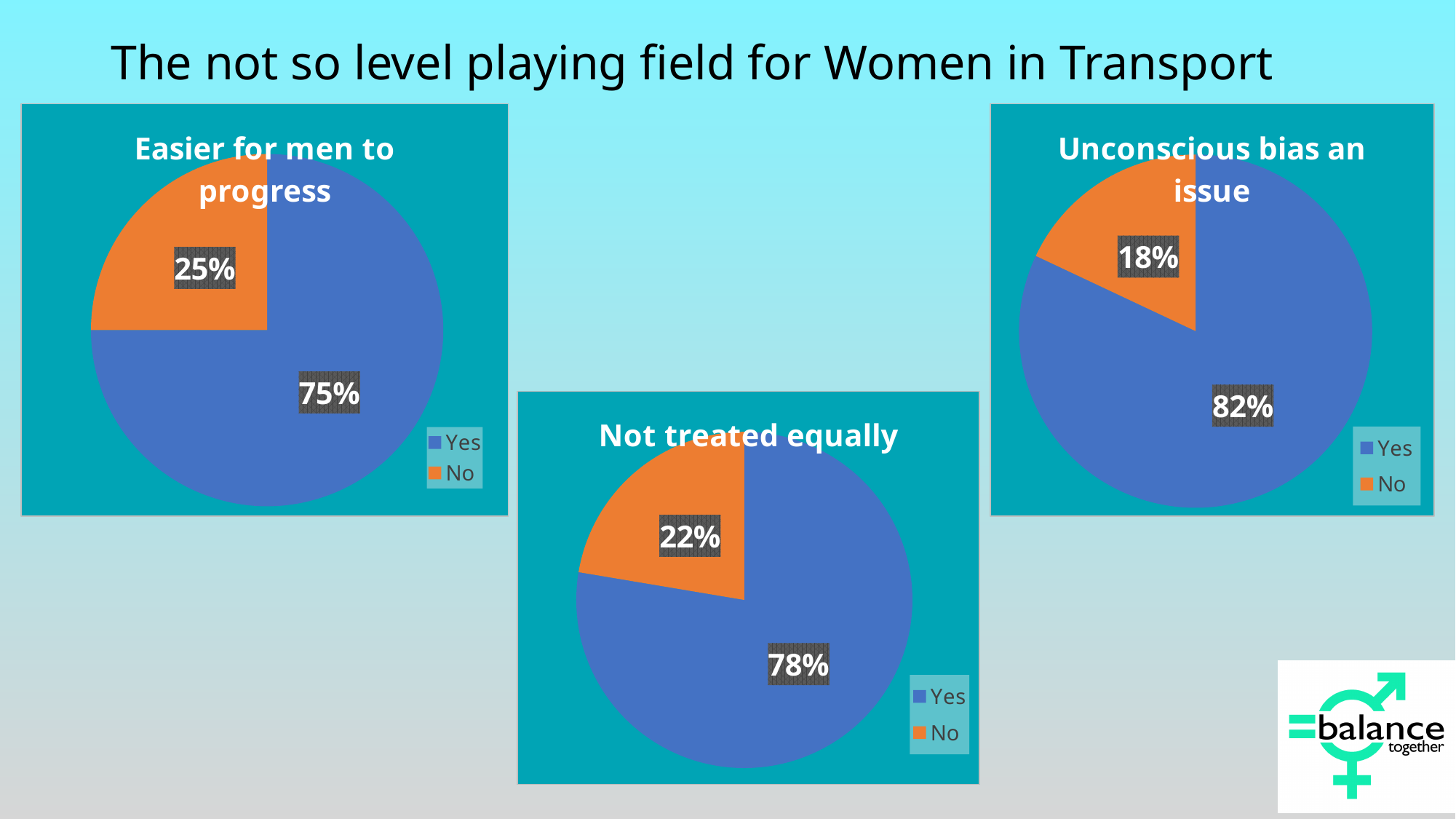
In the 'Unconscious bias an issue' chart, what percentage answered Yes? 82% In the 'Easier for men to progress' chart, what colour is the Yes slice? Blue In the 'Not treated equally' chart, what percentage answered Yes? 78% In the 'Easier for men to progress' chart, what percentage answered No? 25% In the 'Unconscious bias an issue' chart, which response has the larger share? Yes How many series does the legend of the 'Unconscious bias an issue' chart list? 2 In the 'Easier for men to progress' chart, which response has the smaller share? No What kind of chart is the 'Not treated equally' chart? Pie chart In the 'Unconscious bias an issue' chart, what percentage answered No? 18% In the 'Not treated equally' chart, what is the difference between the Yes and No percentages? 56% In the 'Not treated equally' chart, what percentage answered No? 22% In the 'Easier for men to progress' chart, what percentage answered Yes? 75%